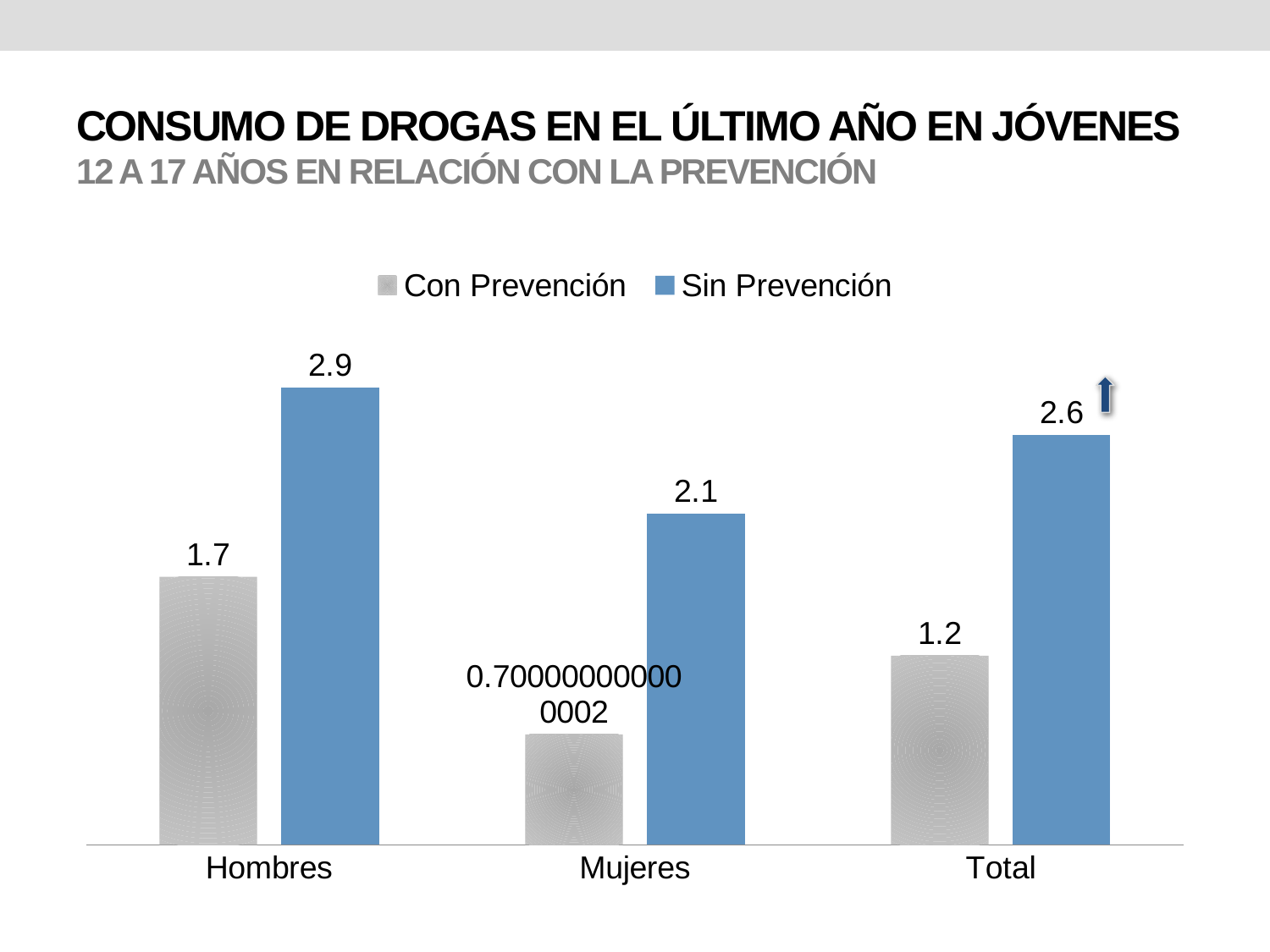
Which is larger for Mujeres: the Con Prevención value or the Sin Prevención value? Sin Prevención How many series does the legend list? 2 What is the value for Mujeres in the Sin Prevención series? 2.1 What is the difference between the Sin Prevención and Con Prevención values for Total? 1.4 Which category has the lowest value in the Con Prevención series? Mujeres What is the difference between the Sin Prevención and Con Prevención values for Hombres? 1.2 How many categories are shown on the x axis? 3 Which category has the highest value in the Sin Prevención series? Hombres What is the value for Hombres in the Con Prevención series? 1.7 What is the value for Total in the Con Prevención series? 1.2 What is the value for Hombres in the Sin Prevención series? 2.9 What is the value for Total in the Sin Prevención series? 2.6